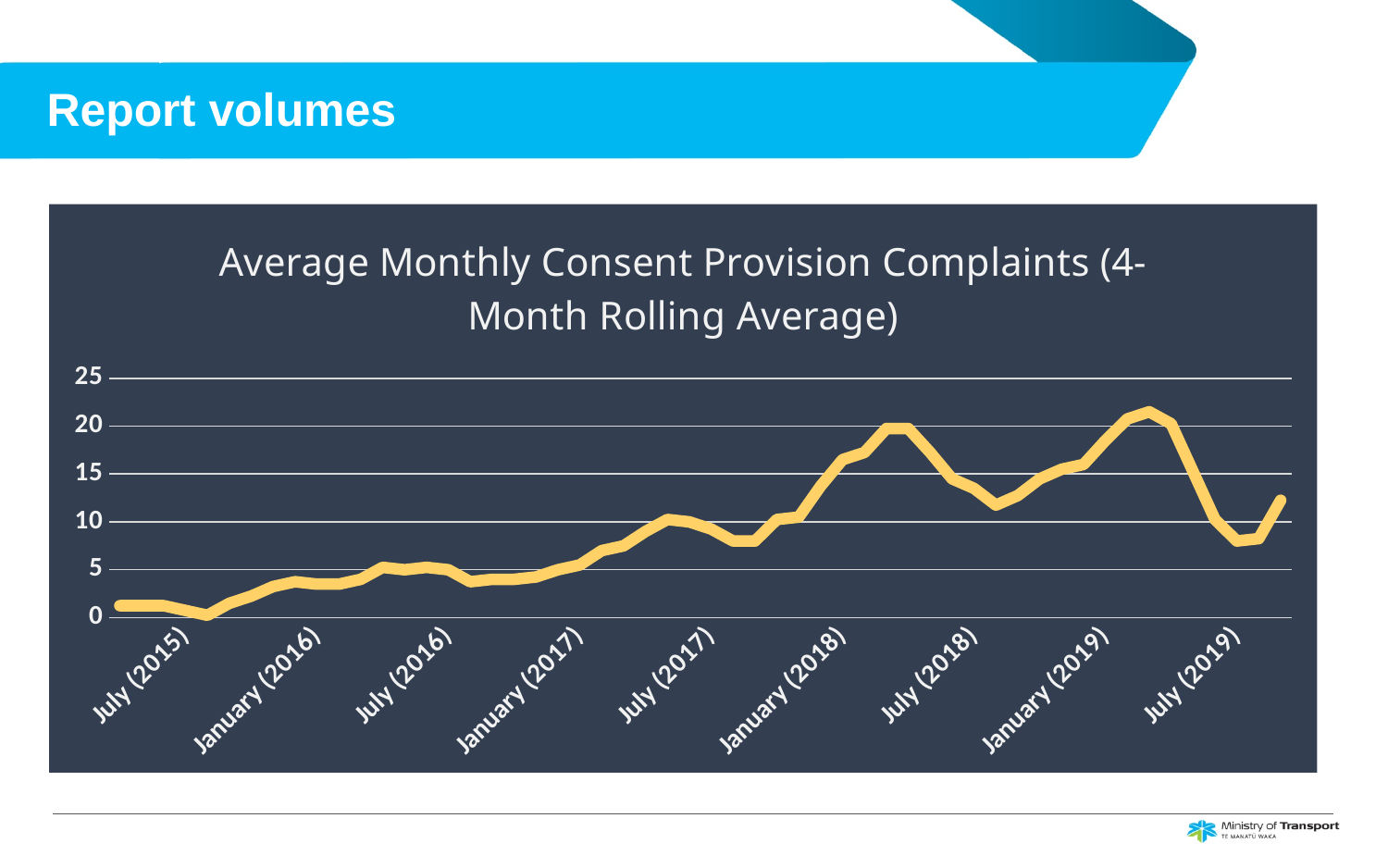
Which of the labelled x-axis points has the lowest value? July (2015) What kind of chart is shown on the slide? line chart How many labels are shown on the x axis of the chart? 9 What colour is the line plotted on the chart? yellow Which is larger, the value for January (2019) or the value for July (2016)? January (2019) What is the title of the chart? Average Monthly Consent Provision Complaints (4-Month Rolling Average) Is the value for July (2015) greater or less than 5? less Is the value for January (2019) greater or less than 10? greater Is the value for January (2016) greater or less than 5? less What is the highest value shown on the y axis? 25 Do the values generally rise or fall from July (2015) to January (2018)? rise